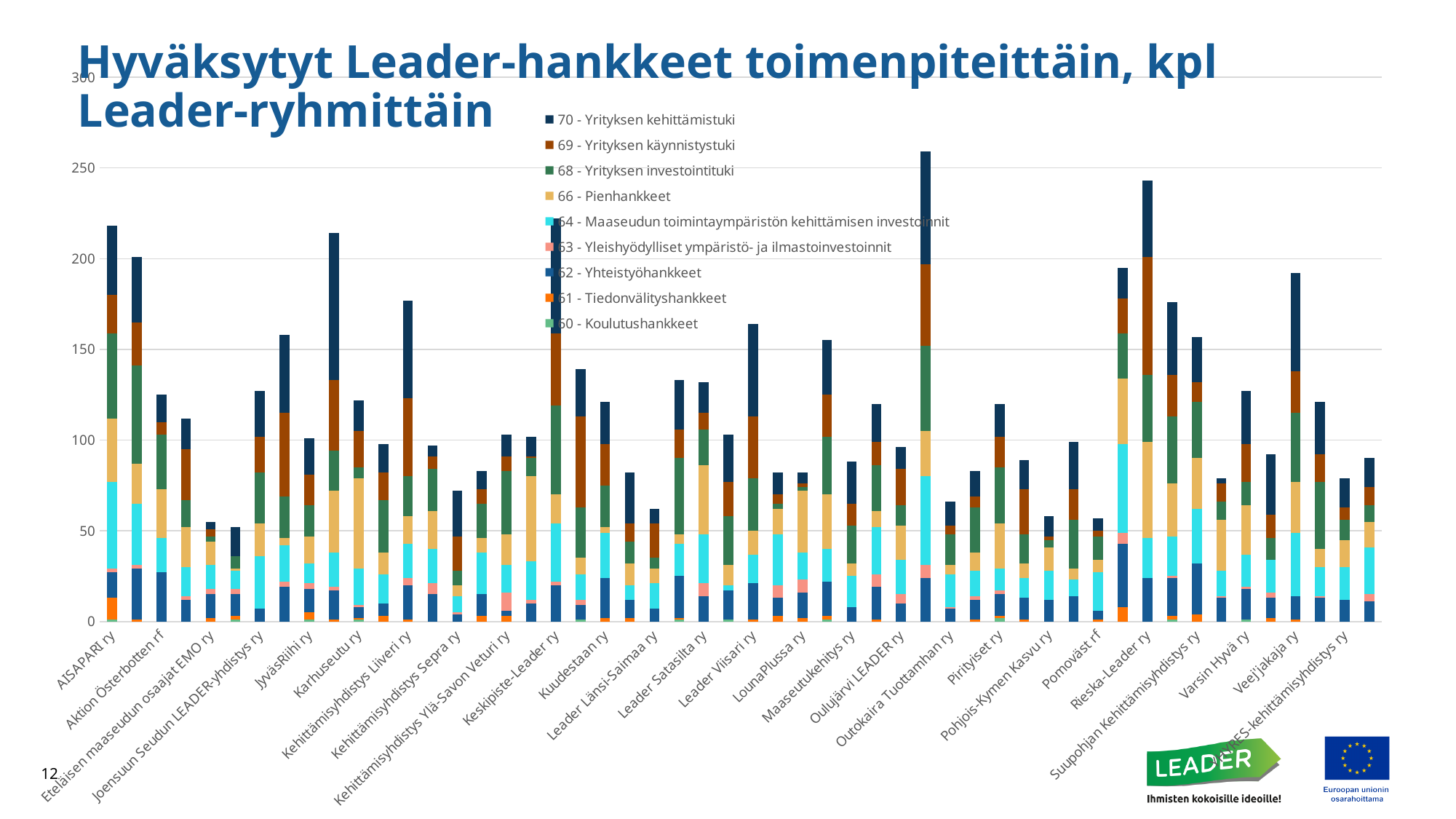
What is the title of the chart? Hyväksytyt Leader-hankkeet toimenpiteittäin, kpl Leader-ryhmittäin Is the total value for Eteläisen maaseudun osaajat EMO ry greater or less than 150? less Is the total value for AISAPARI ry greater or less than 150? greater Is the total value for Kehittämisyhdistys Sepra ry greater or less than 100? less Which has the larger total, Kehittämisyhdistys Sepra ry or Rieska-Leader ry? Rieska-Leader ry Which has the larger total, AISAPARI ry or Eteläisen maaseudun osaajat EMO ry? AISAPARI ry What kind of chart is shown on the slide? Stacked bar chart Which series is listed first in the legend? 70 - Yrityksen kehittämistuki How many series does the legend list? 9